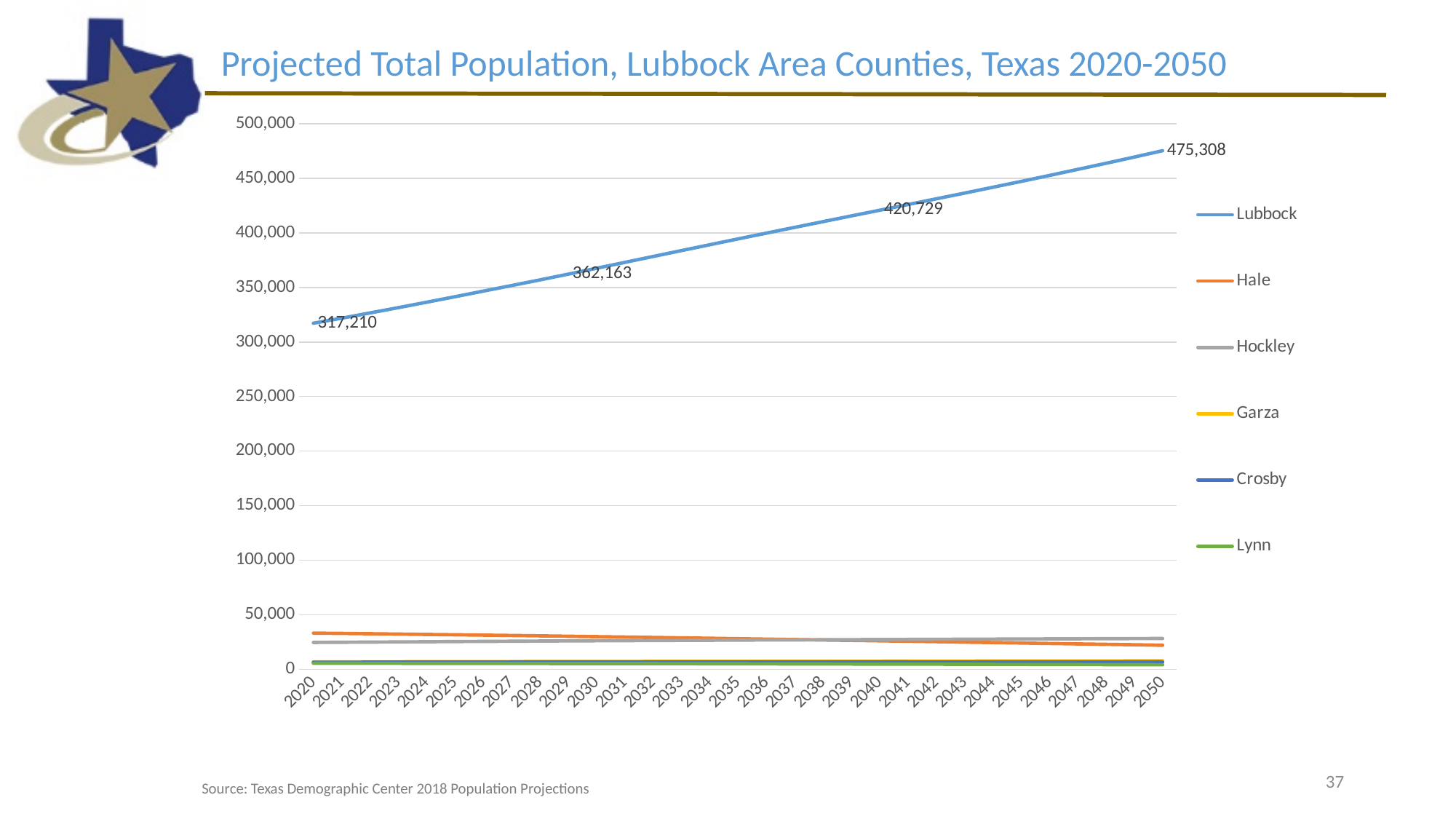
What kind of chart is shown on the slide? line chart What is the projected population of Lubbock County in 2040? 420,729 Is the projected population of Hale County in 2020 greater or less than 50,000? less How many counties (series) does the legend list? 6 Which county has the highest projected population across the whole period? Lubbock What is the projected population of Lubbock County in 2020? 317,210 Does the projected population of Lubbock County rise or fall from 2020 to 2050? rise Does the projected population of Hale County rise or fall from 2020 to 2050? fall By how much is Lubbock County's population projected to grow between 2020 and 2050? 158,098 What is the projected population of Lubbock County in 2050? 475,308